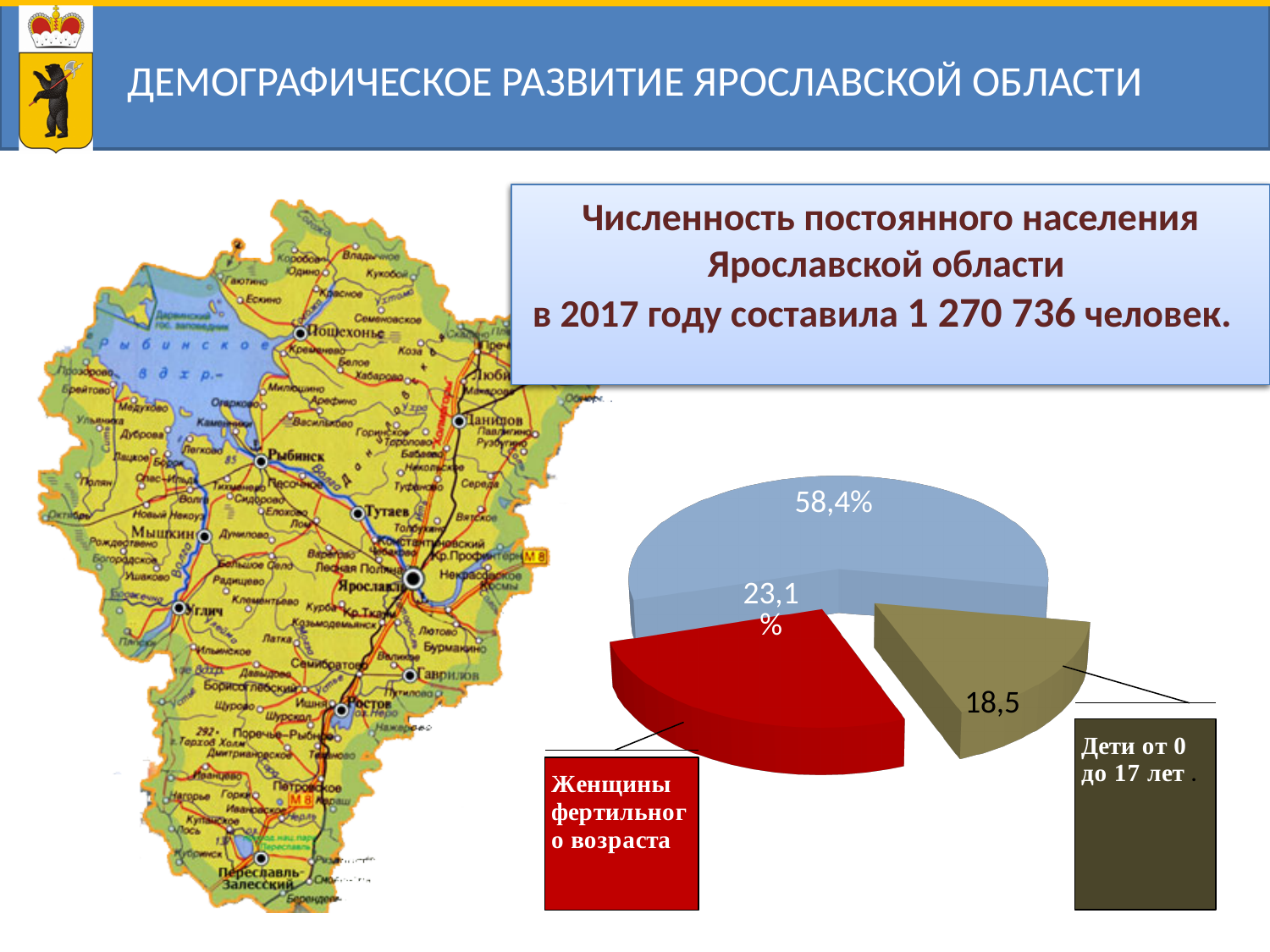
What share of the pie is labelled for Женщины фертильного возраста? 23,1% By how many percentage points does the Женщины фертильного возраста slice (23,1) exceed the Дети от 0 до 17 лет slice (18,5)? 4,6 What colour is the slice for Женщины фертильного возраста? red What kind of chart is shown on the slide? pie chart According to the text box on the slide, what was the permanent population of Yaroslavl Oblast in 2017? 1 270 736 человек Which is larger: the slice for Женщины фертильного возраста or the slice for Дети от 0 до 17 лет? Женщины фертильного возраста How many slices does the pie chart have? 3 What is the value printed on the largest slice of the pie? 58,4% Which labelled slice of the pie is the smallest? Дети от 0 до 17 лет What value is shown for the slice Дети от 0 до 17 лет? 18,5